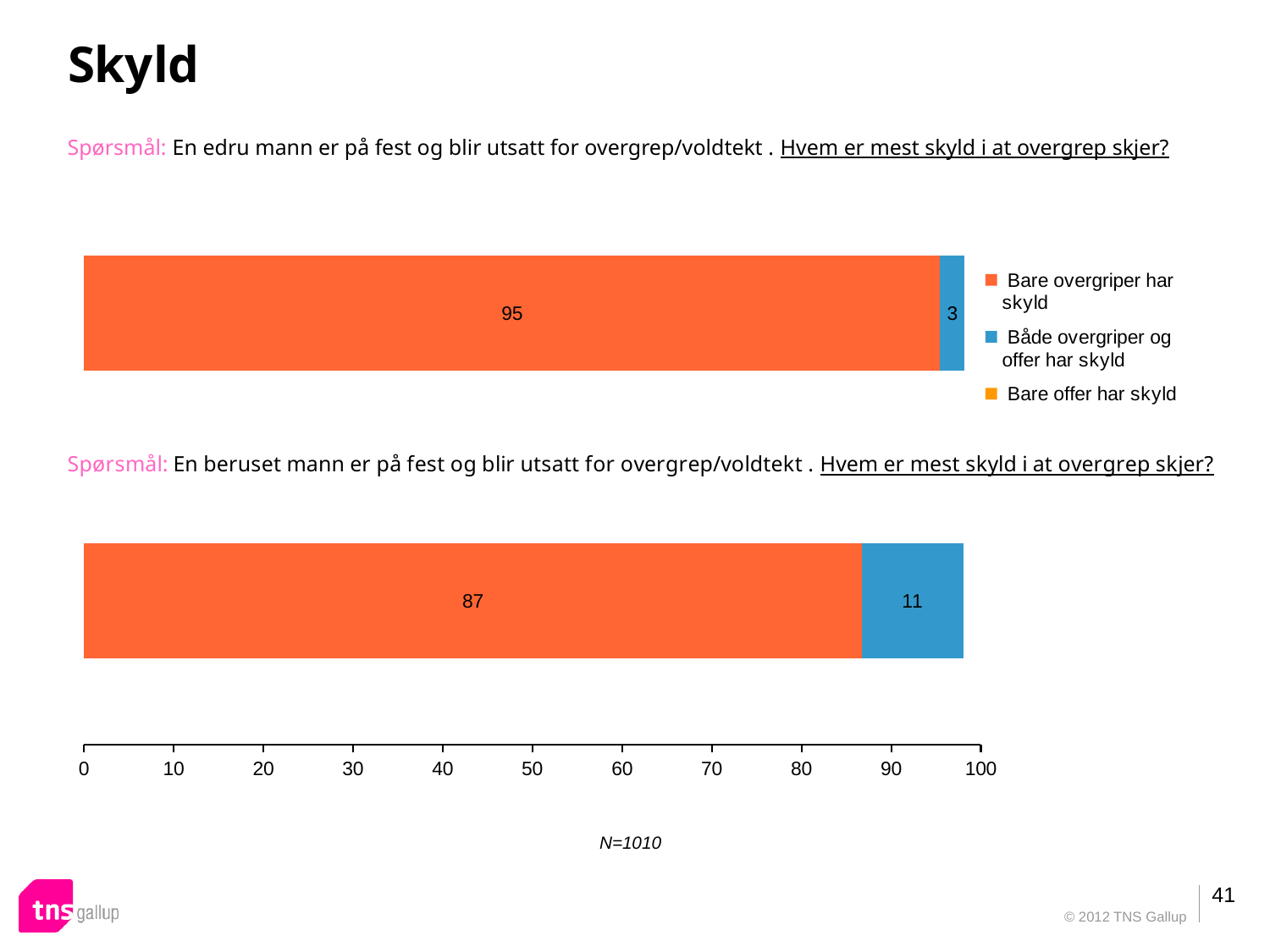
What is the difference between the 'Bare overgriper har skyld' values in the top chart and the bottom chart? 8 What is the total of the labelled segments in the bottom chart (beruset mann)? 98 In the bottom chart (beruset mann), what value is shown for 'Bare overgriper har skyld'? 87 Is the value for 'Bare overgriper har skyld' in the bottom chart greater or less than 80? greater In the top chart (edru mann), what value is shown for 'Bare overgriper har skyld'? 95 In the bottom chart (beruset mann), which segment is the largest? Bare overgriper har skyld In the top chart (edru mann), what value is shown for 'Både overgriper og offer har skyld'? 3 How many series does the legend list? 3 What kind of chart is used on this slide? stacked bar chart What is the total of the labelled segments in the top chart (edru mann)? 98 Which chart has the larger value for 'Både overgriper og offer har skyld', the top chart (edru mann) or the bottom chart (beruset mann)? the bottom chart (beruset mann) In the bottom chart (beruset mann), what value is shown for 'Både overgriper og offer har skyld'? 11